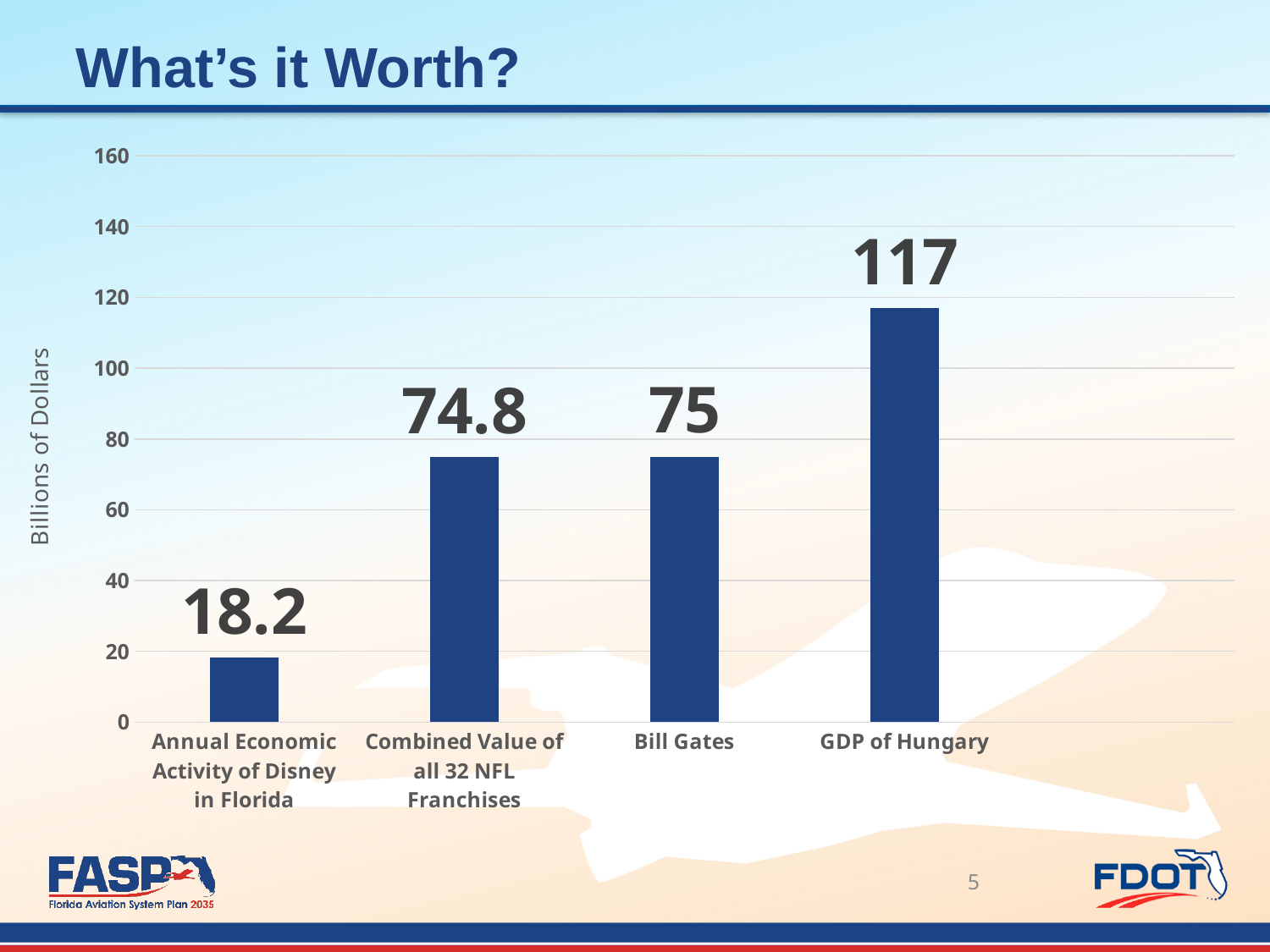
How many categories are shown in the chart? 4 What is the value for GDP of Hungary? 117 What is the difference between the value for Bill Gates and the value for Annual Economic Activity of Disney in Florida? 56.8 What kind of chart is shown on the slide? Bar chart Which is larger: the value for GDP of Hungary or the value for Combined Value of all 32 NFL Franchises? GDP of Hungary What is the label of the vertical axis? Billions of Dollars What is the value for Annual Economic Activity of Disney in Florida? 18.2 What is the value for Bill Gates? 75 Which category has the lowest value? Annual Economic Activity of Disney in Florida Which category has the highest value? GDP of Hungary What is the value for Combined Value of all 32 NFL Franchises? 74.8 What is the difference between the value for GDP of Hungary and the value for Bill Gates? 42